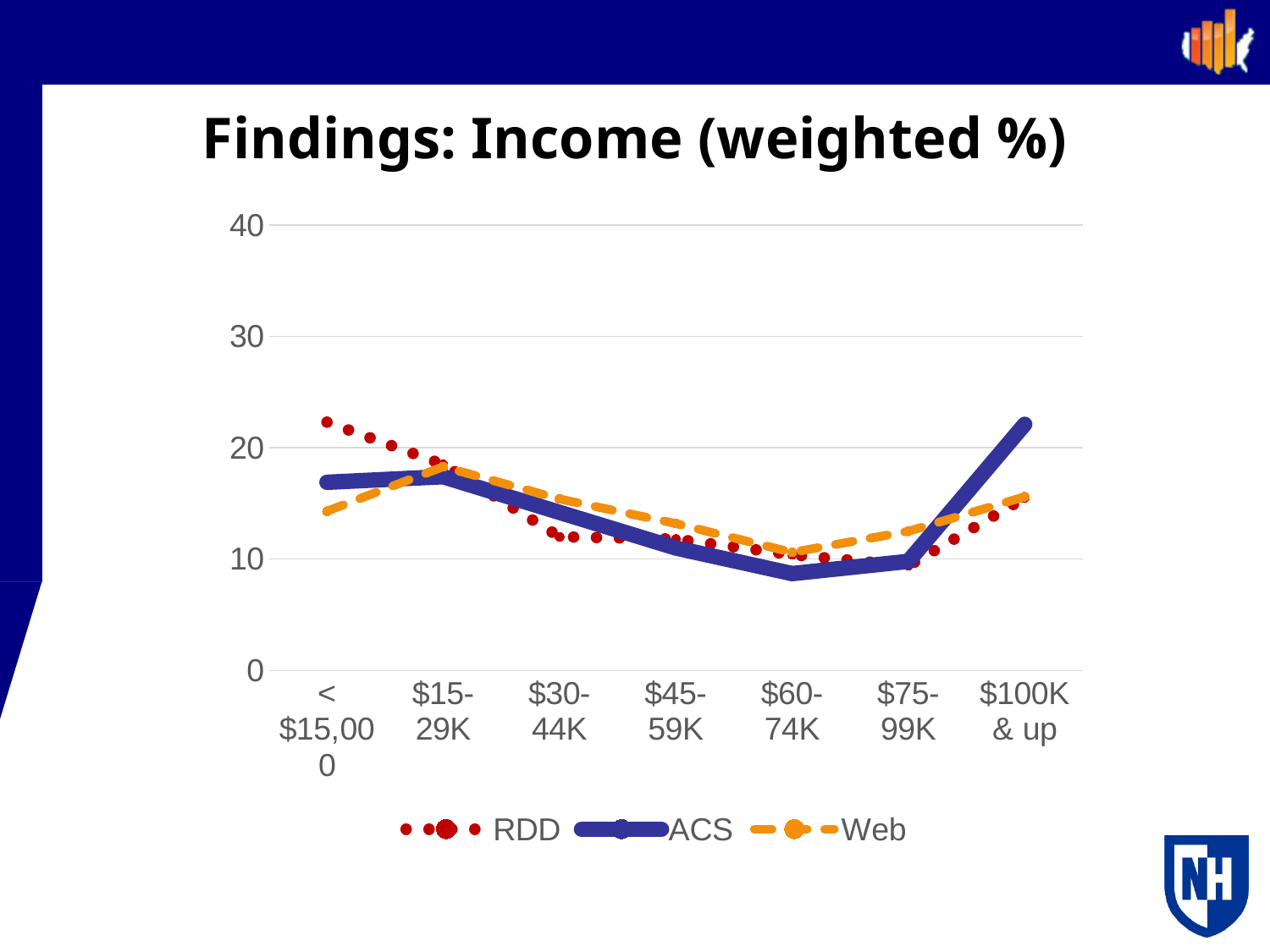
In which income category is the ACS series highest? $100K & up What is the title of the chart? Findings: Income (weighted %) What kind of chart is shown on the slide? line chart For the < $15,000 category, which is larger, RDD or Web? RDD How many series does the legend list? 3 Is the RDD value for < $15,000 greater or less than 20? greater How many income categories are shown on the x axis? 7 Is the ACS value for $100K & up greater or less than 20? greater In which income category is the RDD series highest? < $15,000 In which income category is the Web series lowest? $60-74K Is the Web value for < $15,000 greater or less than 20? less Which series are listed in the legend? RDD, ACS, Web